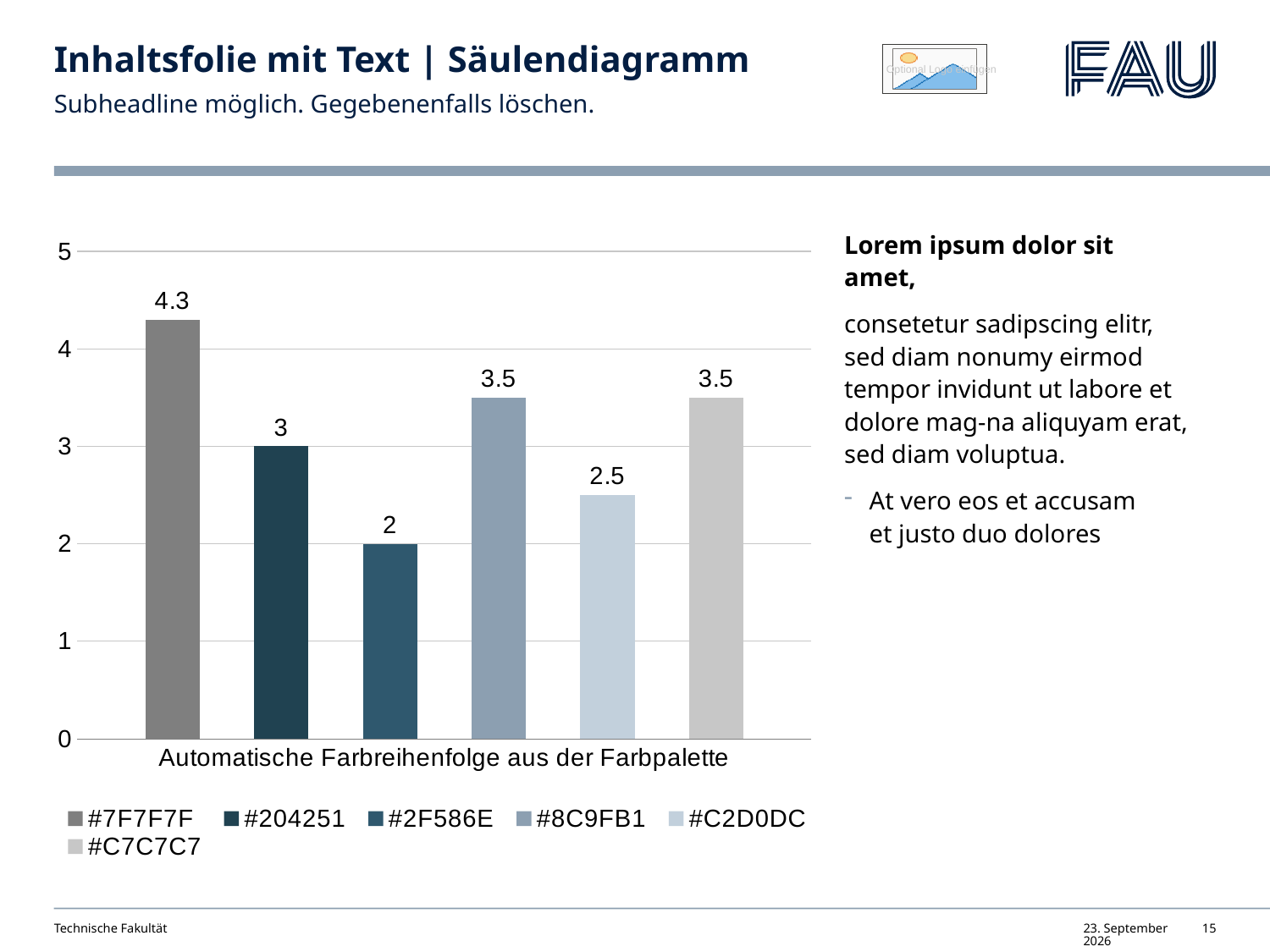
What is the value of the #7F7F7F series? 4.3 What is the value of the #C2D0DC series? 2.5 What is the category label shown on the x axis? Automatische Farbreihenfolge aus der Farbpalette How many series does the legend list? 6 Which is larger, the value for #8C9FB1 or the value for #C2D0DC? #8C9FB1 What type of chart is shown on the slide? bar chart Which series has the lowest value? #2F586E What is the difference between the values of #7F7F7F and #204251? 1.3 What is the value of the #204251 series? 3 Which series has the highest value? #7F7F7F What is the value of the #2F586E series? 2 What is the difference between the values of #C7C7C7 and #2F586E? 1.5